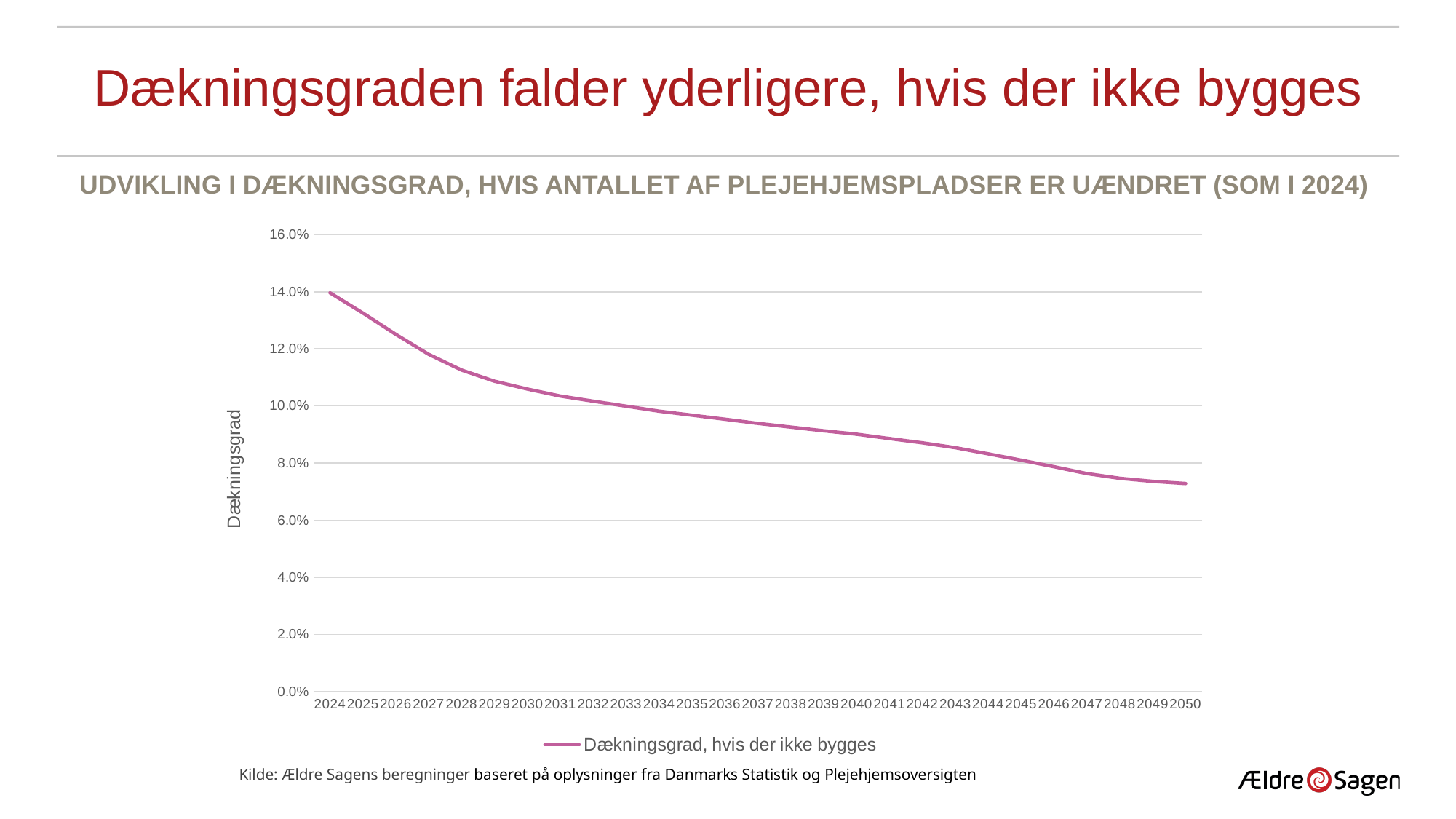
What kind of chart is shown on the slide? line chart Is the value for 2024 greater or less than 12.0%? greater Does the coverage rate (dækningsgrad) rise or fall from 2024 to 2050? fall Which year has the highest coverage rate? 2024 Which year has the lowest coverage rate? 2050 How many series does the legend list? 1 Is the value for 2050 greater or less than 8.0%? less Which is larger, the value for 2027 or the value for 2045? 2027 Is the value for 2040 greater or less than 8.0%? greater How many years are plotted along the x axis? 27 What is the legend entry for the plotted line? Dækningsgrad, hvis der ikke bygges